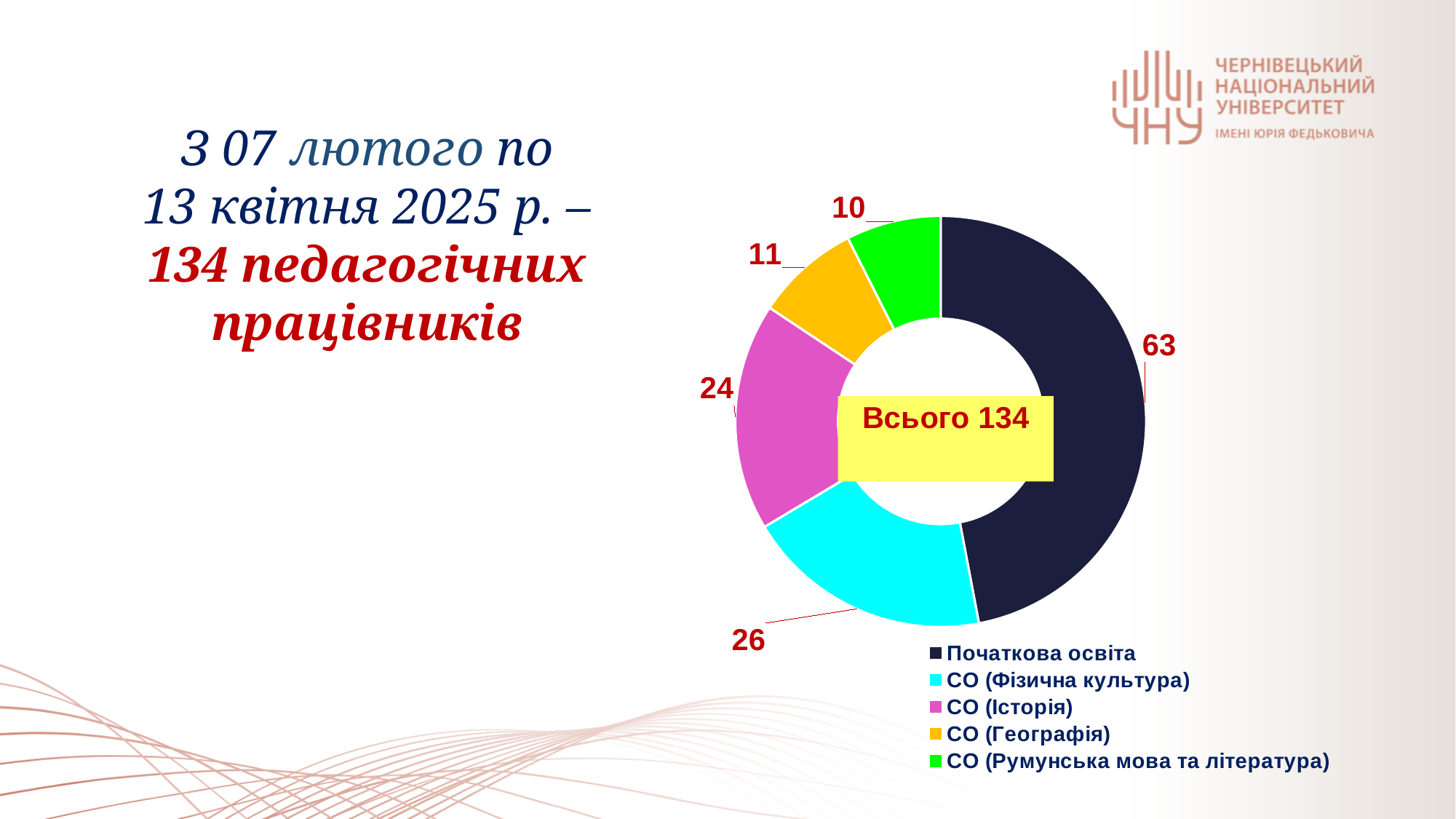
Which category has the highest value? Початкова освіта What is the value for Початкова освіта? 63 Which category has the lowest value? СО (Румунська мова та література) How many categories does the chart show? 5 Which is larger, the value for СО (Історія) or the value for СО (Географія)? СО (Історія) What is the difference between the values for Початкова освіта and СО (Фізична культура)? 37 What is the value for СО (Історія)? 24 What total is shown in the centre of the chart? Всього 134 What is the value for СО (Географія)? 11 What is the value for СО (Румунська мова та література)? 10 What is the value for СО (Фізична культура)? 26 What kind of chart is shown on the slide? Doughnut (pie) chart